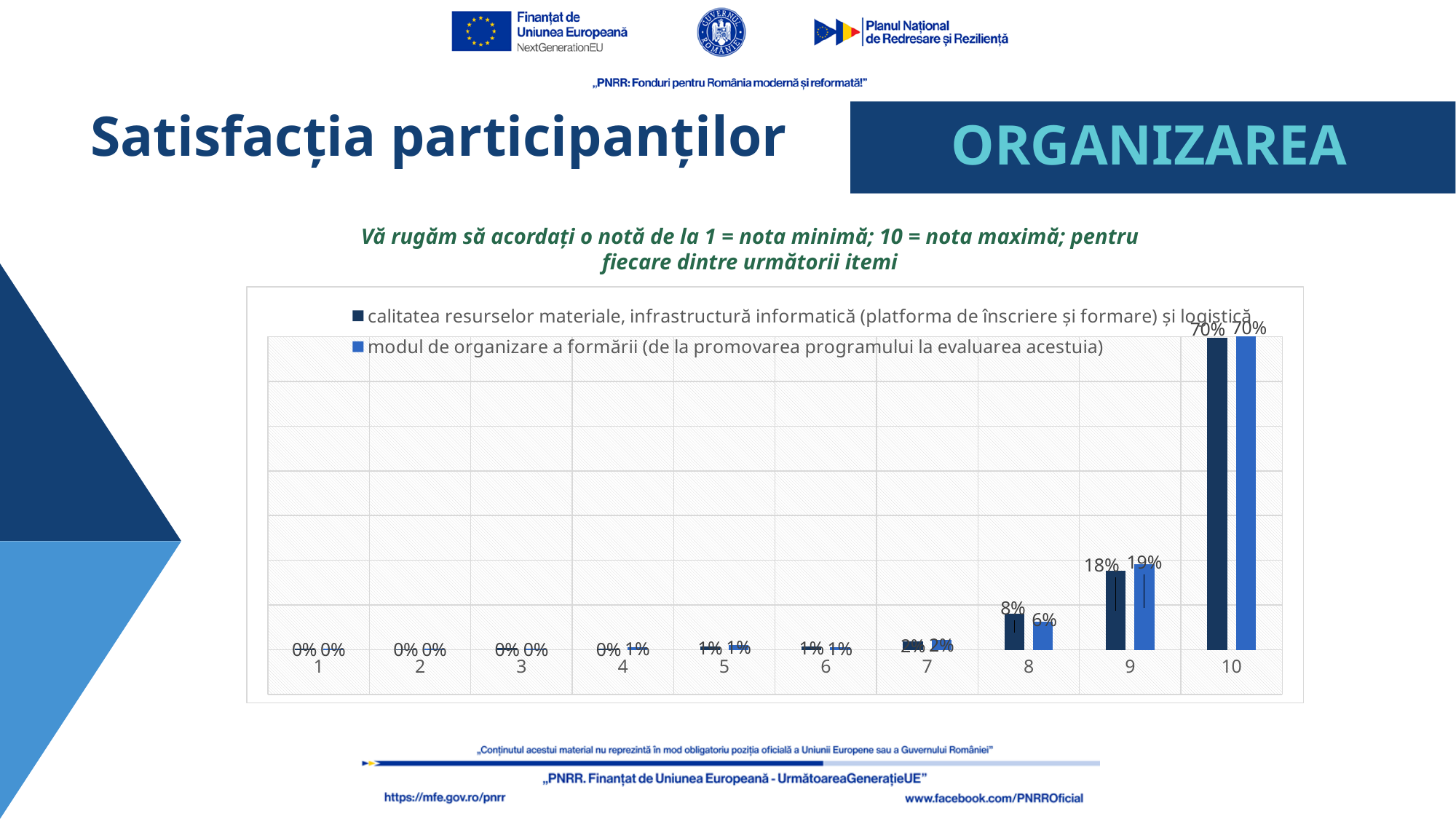
What is the value for rating 9 for the series 'modul de organizare a formării (de la promovarea programului la evaluarea acestuia)'? 19% How many rating categories are shown on the x axis of the chart? 10 Which rating has the highest value for the series 'modul de organizare a formării (de la promovarea programului la evaluarea acestuia)'? 10 How many series does the chart legend list? 2 What is the difference between the values for rating 10 and rating 9 for the series 'calitatea resurselor materiale, infrastructură informatică (platforma de înscriere și formare) și logistică'? 52% Do the values for the series 'modul de organizare a formării (de la promovarea programului la evaluarea acestuia)' generally rise or fall from rating 1 to rating 10? rise What is the value for rating 8 for the series 'calitatea resurselor materiale, infrastructură informatică (platforma de înscriere și formare) și logistică'? 8% What is the value for rating 10 for the series 'calitatea resurselor materiale, infrastructură informatică (platforma de înscriere și formare) și logistică'? 70% For rating 8, which series has the larger value: 'calitatea resurselor materiale...' or 'modul de organizare a formării...'? calitatea resurselor materiale, infrastructură informatică (platforma de înscriere și formare) și logistică What is the value for rating 8 for the series 'modul de organizare a formării (de la promovarea programului la evaluarea acestuia)'? 6% What kind of chart is shown on the slide? bar chart What colour are the bars for the series 'calitatea resurselor materiale, infrastructură informatică (platforma de înscriere și formare) și logistică'? dark navy blue